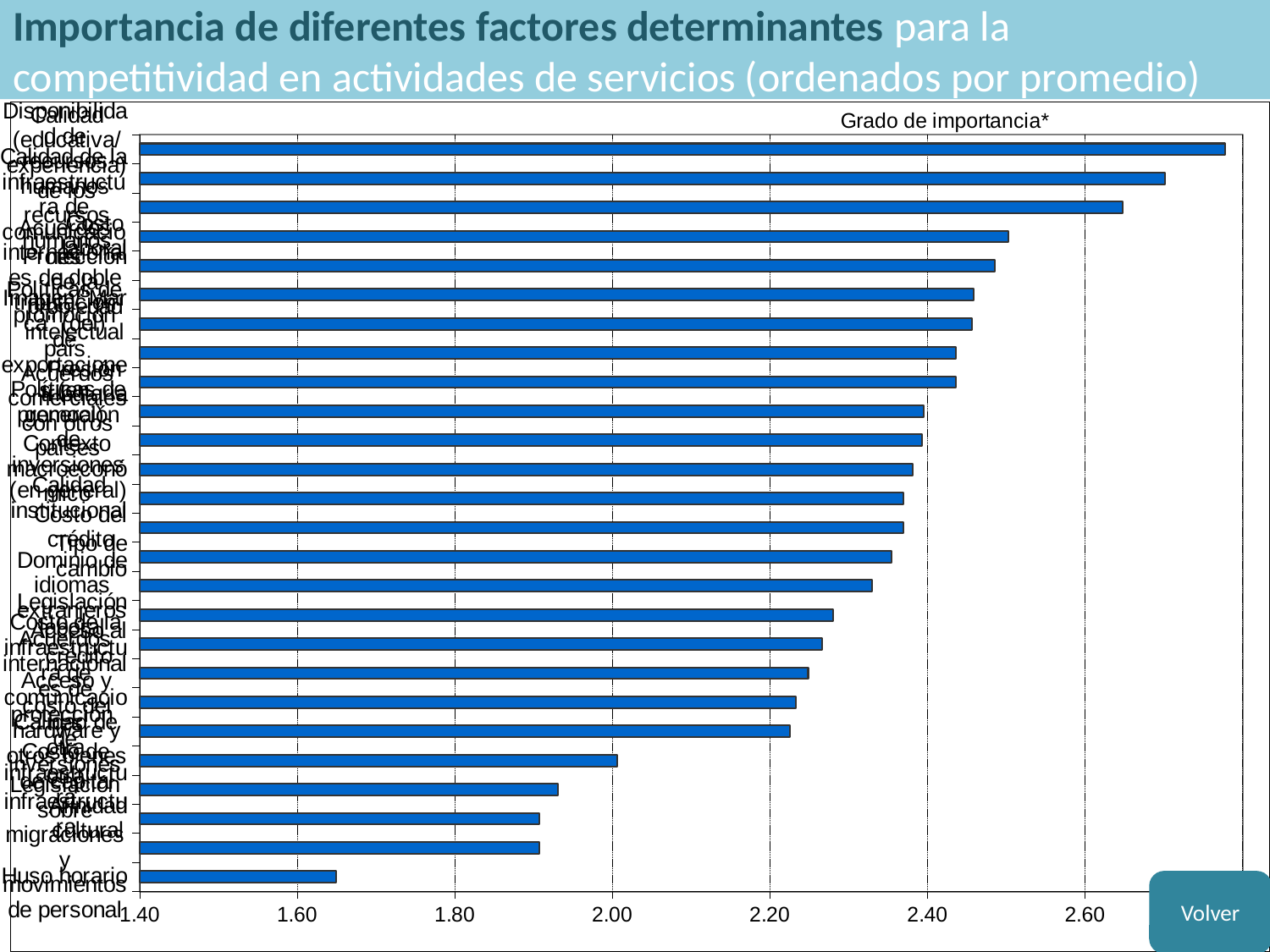
How many bars are plotted in the chart? 26 Which bar is longer, the top bar or the bottom bar? the top bar Is the value of the second bar from the top greater or less than 2.60? greater What kind of chart is shown on the slide? bar chart Do the bar lengths increase or decrease going from the top bar to the bottom bar? decrease Is the value of the second bar from the bottom greater or less than 2.00? less Is the value of the shortest (bottom) bar greater or less than 1.60? greater What is the title shown above the chart's plot area? Grado de importancia* What is the lowest value shown on the horizontal axis? 1.40